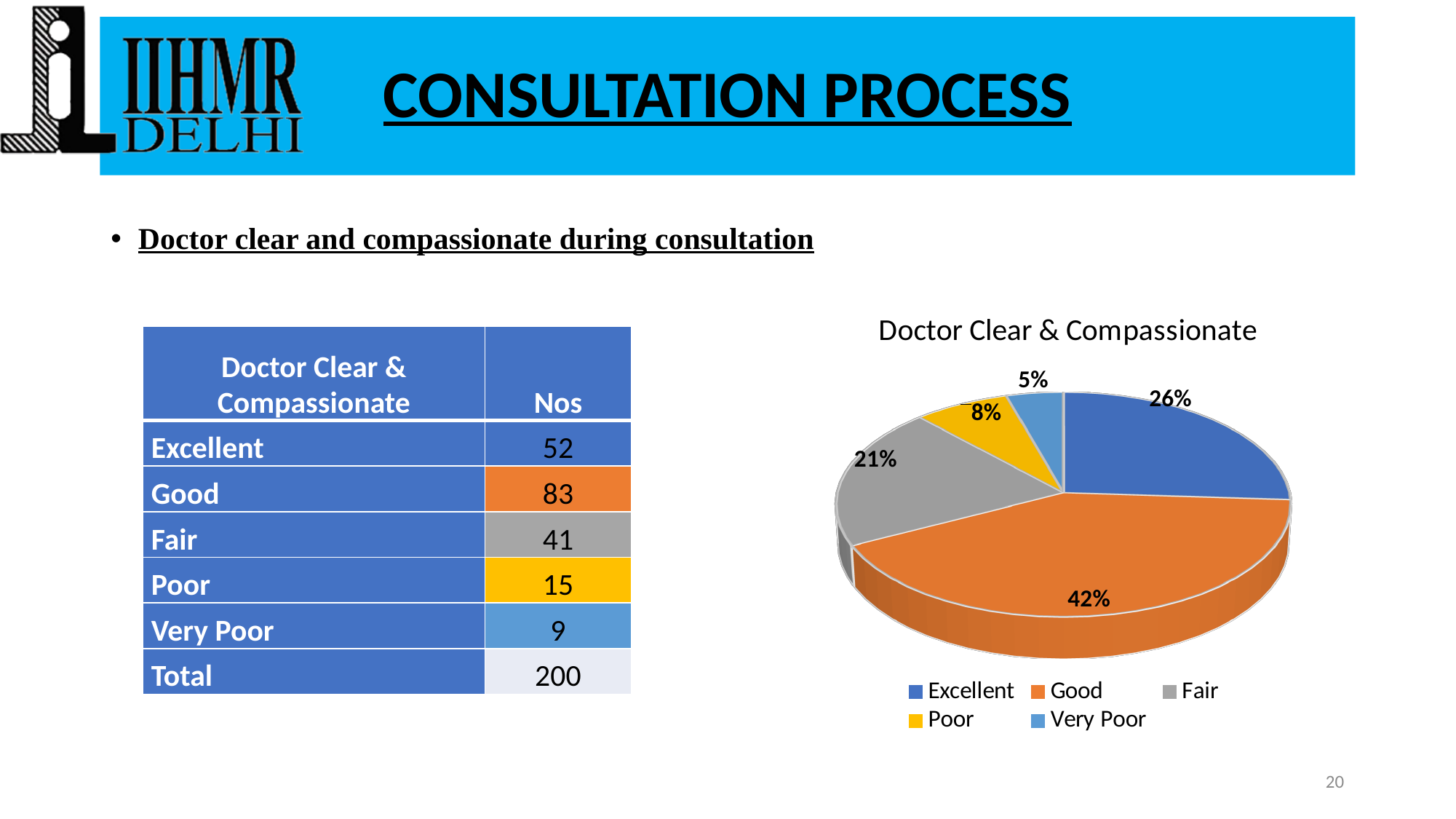
What kind of chart is shown on the slide? pie chart Which slice is larger in the pie chart, Fair or Poor? Fair What percentage share does the Excellent slice have in the pie chart? 26% What percentage share does the Very Poor slice have in the pie chart? 5% What percentage share does the Good slice have in the pie chart? 42% What is the difference in percentage points between the Good slice and the Excellent slice? 16% Which category has the largest slice in the pie chart? Good What is the title of the chart? Doctor Clear & Compassionate Which category has the smallest slice in the pie chart? Very Poor How many slices does the pie chart have? 5 How many entries does the legend of the pie chart list? 5